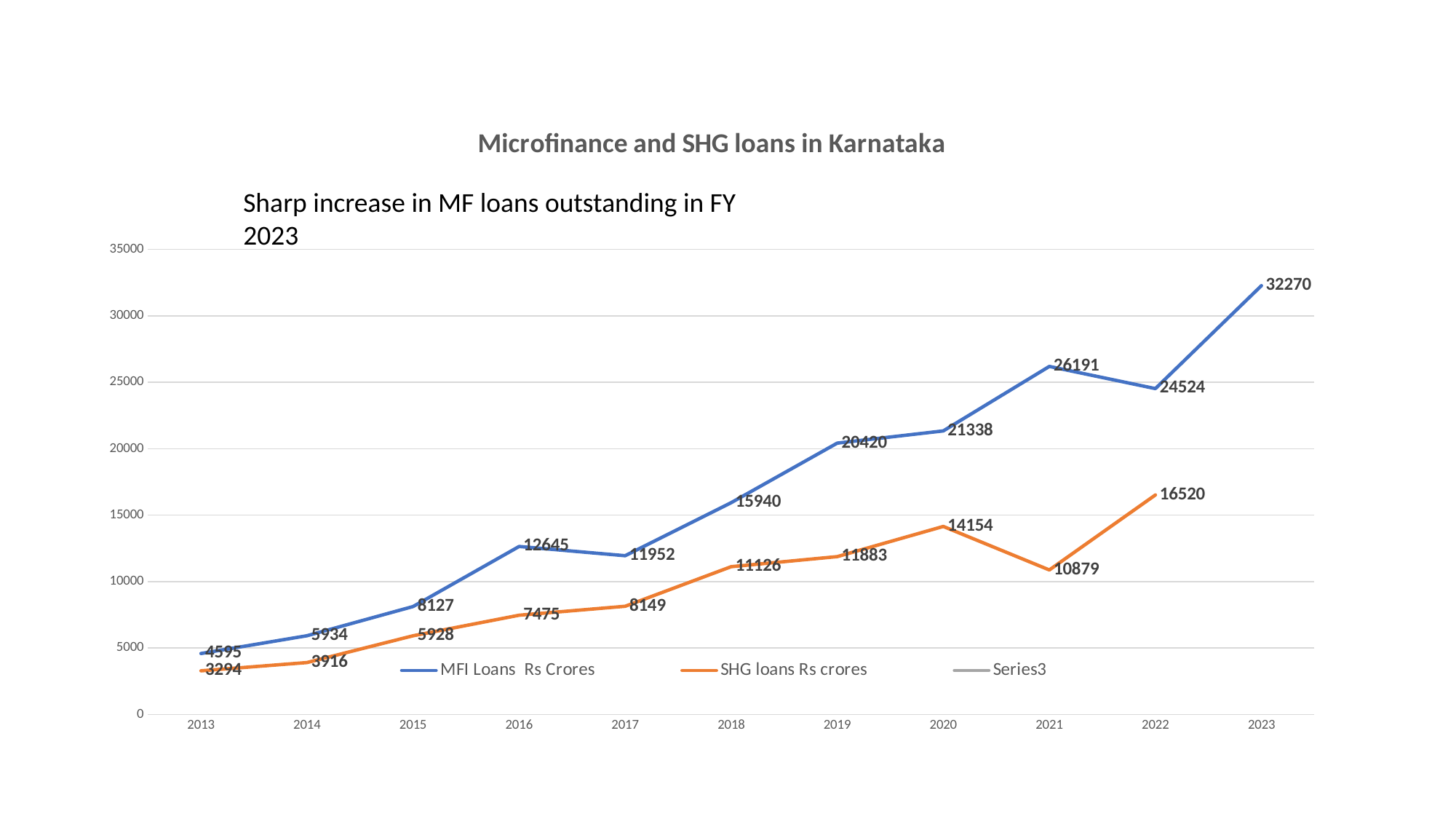
How many years are shown on the x axis? 11 In which year is the SHG loans Rs crores value lowest? 2013 What is the value of SHG loans Rs crores in 2020? 14154 What is the title of the chart? Microfinance and SHG loans in Karnataka How many series does the legend list? 3 What is the value of MFI Loans Rs Crores in 2023? 32270 What is the value of MFI Loans Rs Crores in 2017? 11952 In which year is the MFI Loans Rs Crores value highest? 2023 What type of chart is shown on the slide? line chart Which is larger in 2021: MFI Loans Rs Crores or SHG loans Rs crores? MFI Loans Rs Crores Does the MFI Loans Rs Crores value rise or fall from 2021 to 2022? fall What is the difference between MFI Loans Rs Crores and SHG loans Rs crores in 2022? 8004